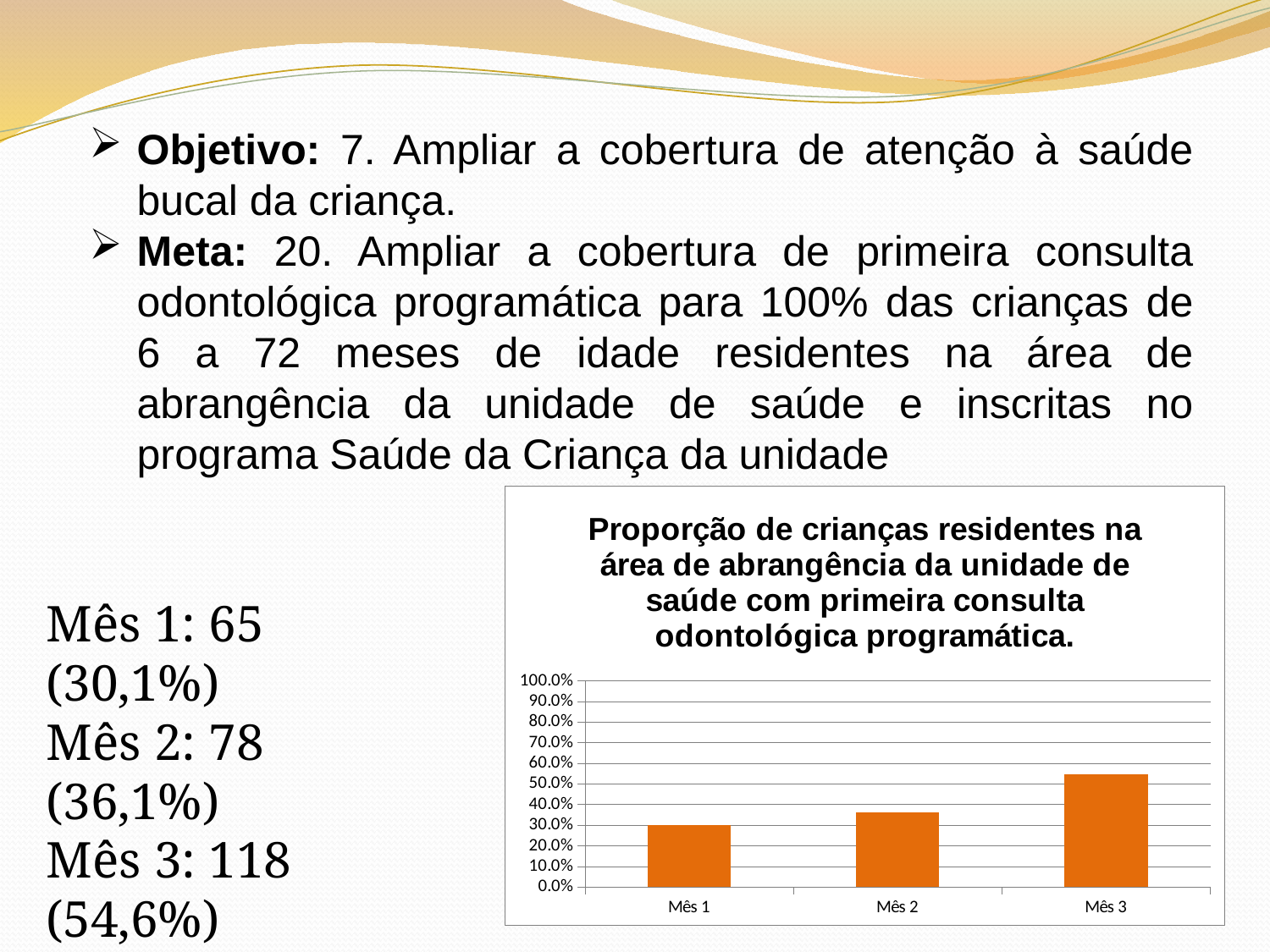
What is the maximum value shown on the chart's vertical axis? 100.0% Which month has the highest proportion of children with a first programmatic dental consultation? Mês 3 Is the value for Mês 1 greater or less than 40.0%? less According to the slide, what proportion is shown for Mês 1? 30,1% Which is larger, the value for Mês 2 or the value for Mês 3? Mês 3 Do the values rise or fall from Mês 1 to Mês 3? rise According to the slide, what proportion is shown for Mês 3? 54,6% Which month has the lowest proportion of children with a first programmatic dental consultation? Mês 1 Is the value for Mês 2 greater or less than 30.0%? greater Is the value for Mês 3 greater or less than 50.0%? greater How many categories (months) are plotted on the chart? 3 What type of chart is shown on the slide? bar chart